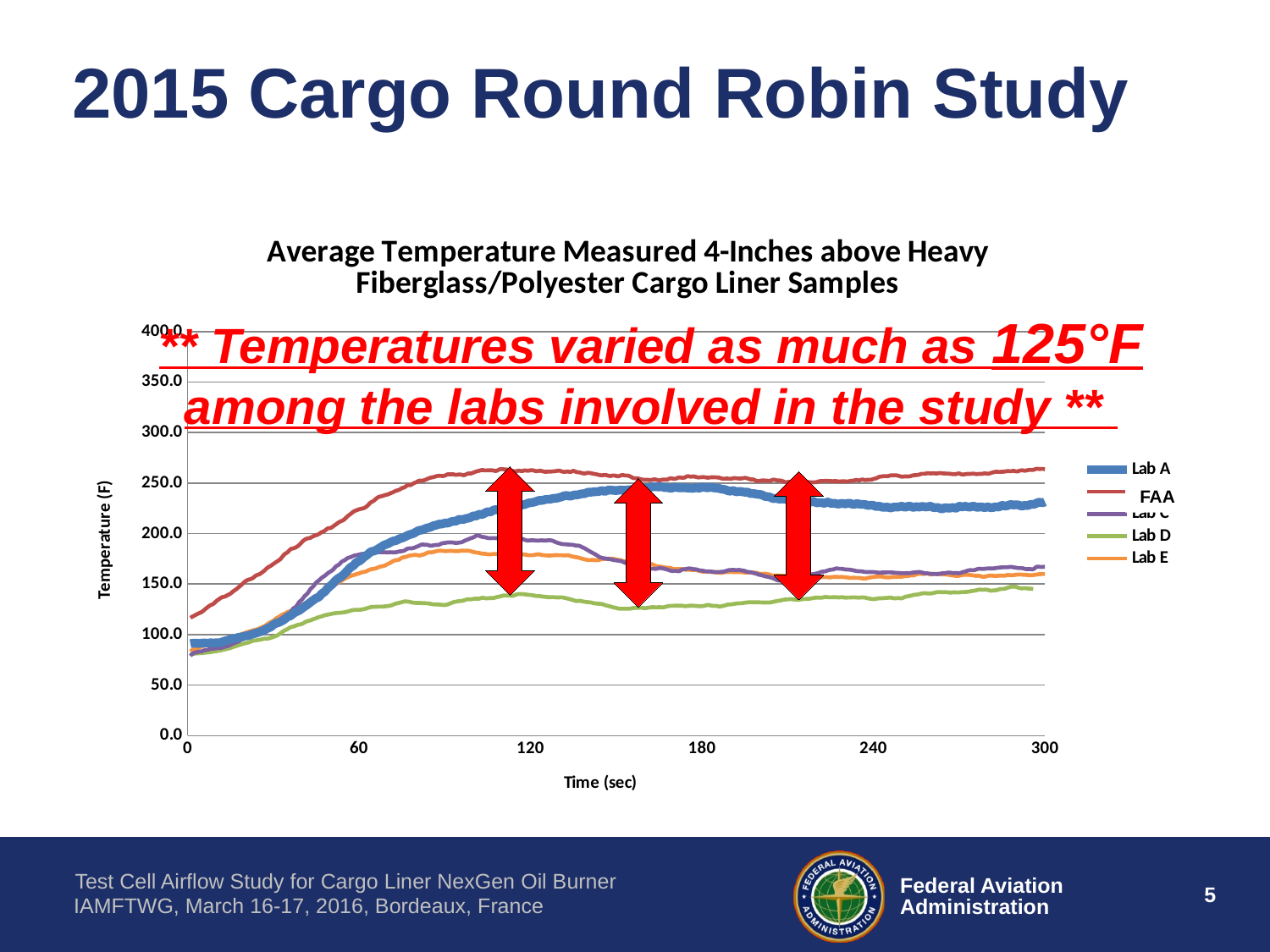
Does the FAA temperature rise or fall between 0 and 60 seconds? rise At 120 seconds, which series has the higher temperature, Lab A or Lab D? Lab A Is the FAA temperature at 300 seconds greater or less than 250? greater Is the Lab D temperature at 180 seconds greater or less than 150? less What is the title of the chart? Average Temperature Measured 4-Inches above Heavy Fiberglass/Polyester Cargo Liner Samples What kind of chart is shown on the slide? line chart Which series has the highest temperature at 300 seconds? FAA Is the Lab A temperature at 300 seconds greater or less than 250? less How many series does the chart legend list? 5 Which series has the lowest temperature at 300 seconds? Lab D What is the label of the x axis of the chart? Time (sec)